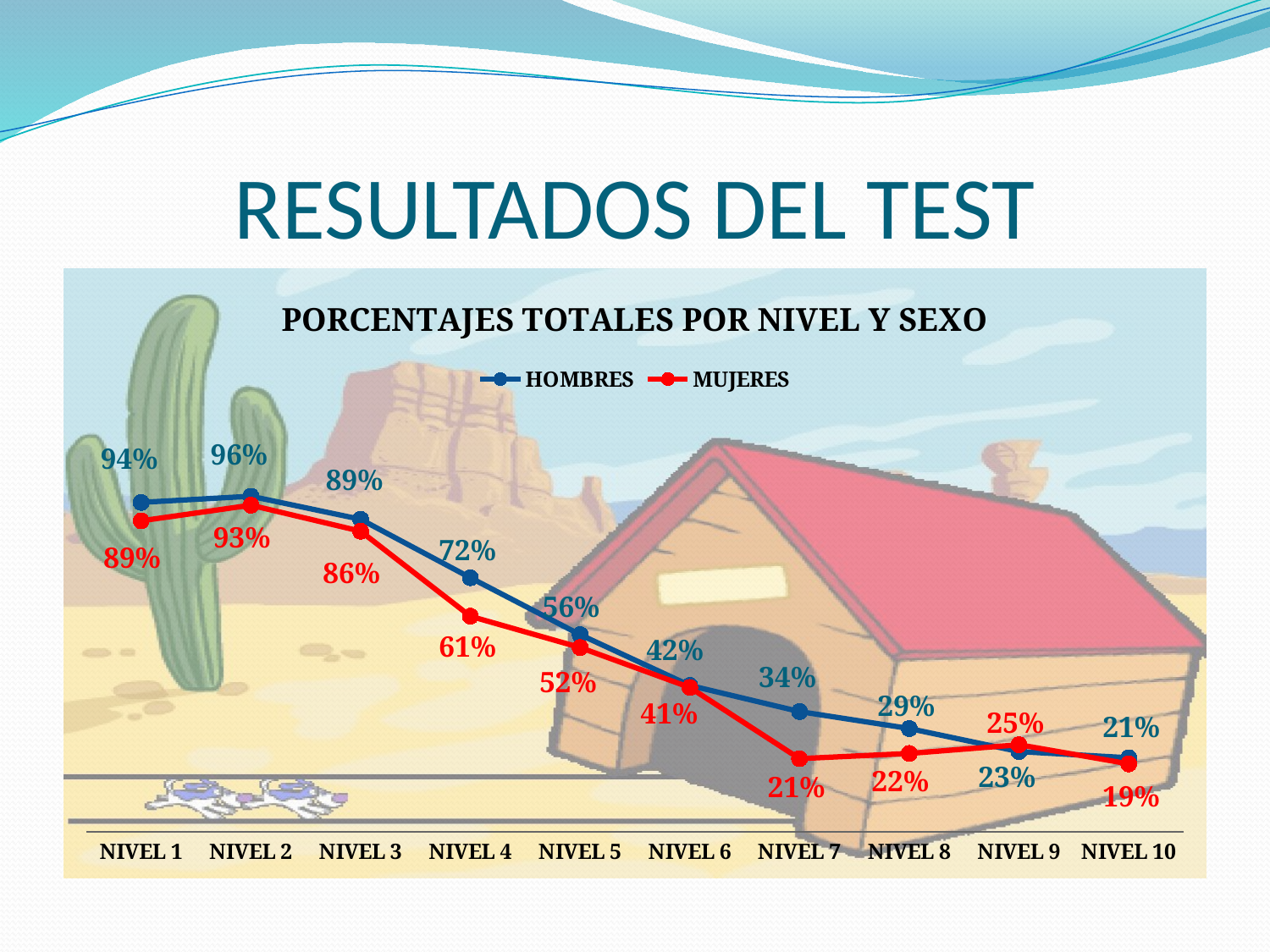
How many levels are shown on the x axis? 10 What is the HOMBRES value at NIVEL 10? 21% Which series has the larger value at NIVEL 9, HOMBRES or MUJERES? MUJERES At which level is the HOMBRES series highest? NIVEL 2 What kind of chart is shown? line chart What is the HOMBRES value at NIVEL 4? 72% What is the MUJERES value at NIVEL 7? 21% What is the title of the chart? PORCENTAJES TOTALES POR NIVEL Y SEXO What is the difference between the HOMBRES and MUJERES values at NIVEL 4? 11% How many series does the legend list? 2 At which level is the MUJERES series lowest? NIVEL 10 Do the HOMBRES values generally rise or fall from NIVEL 2 to NIVEL 10? fall